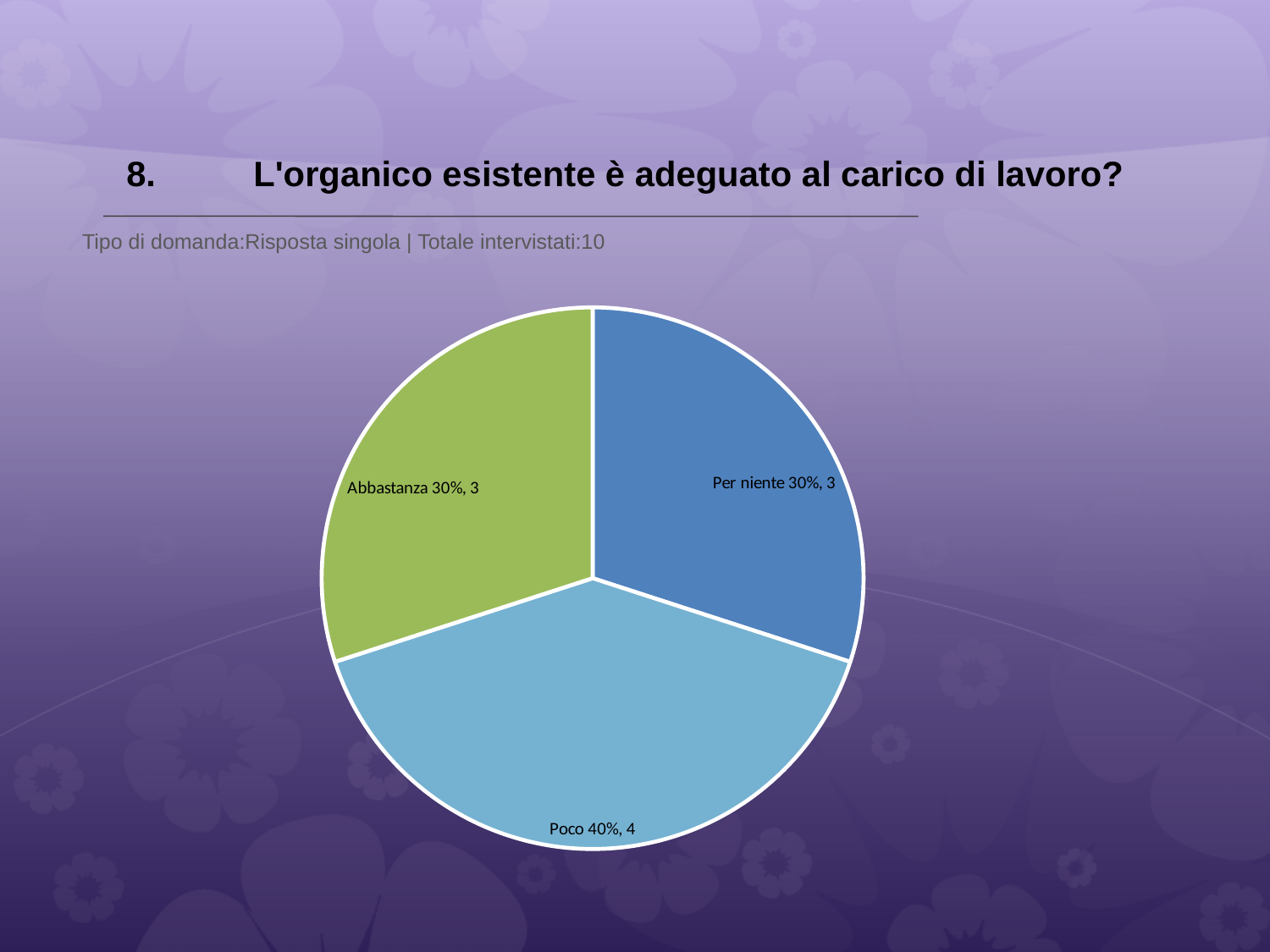
Which slice is larger, 'Poco' or 'Per niente'? Poco What percentage share does the 'Abbastanza' slice have? 30% Which response has the largest slice of the pie? Poco How many slices does the pie chart have? 3 How many respondents answered 'Poco'? 4 What kind of chart is shown on the slide? pie chart What percentage share does the 'Per niente' slice have? 30% How many respondents answered 'Abbastanza'? 3 What colour is the 'Abbastanza' slice? green What percentage share does the 'Poco' slice have? 40% What is the difference in respondent count between 'Poco' and 'Abbastanza'? 1 How many respondents answered 'Per niente'? 3